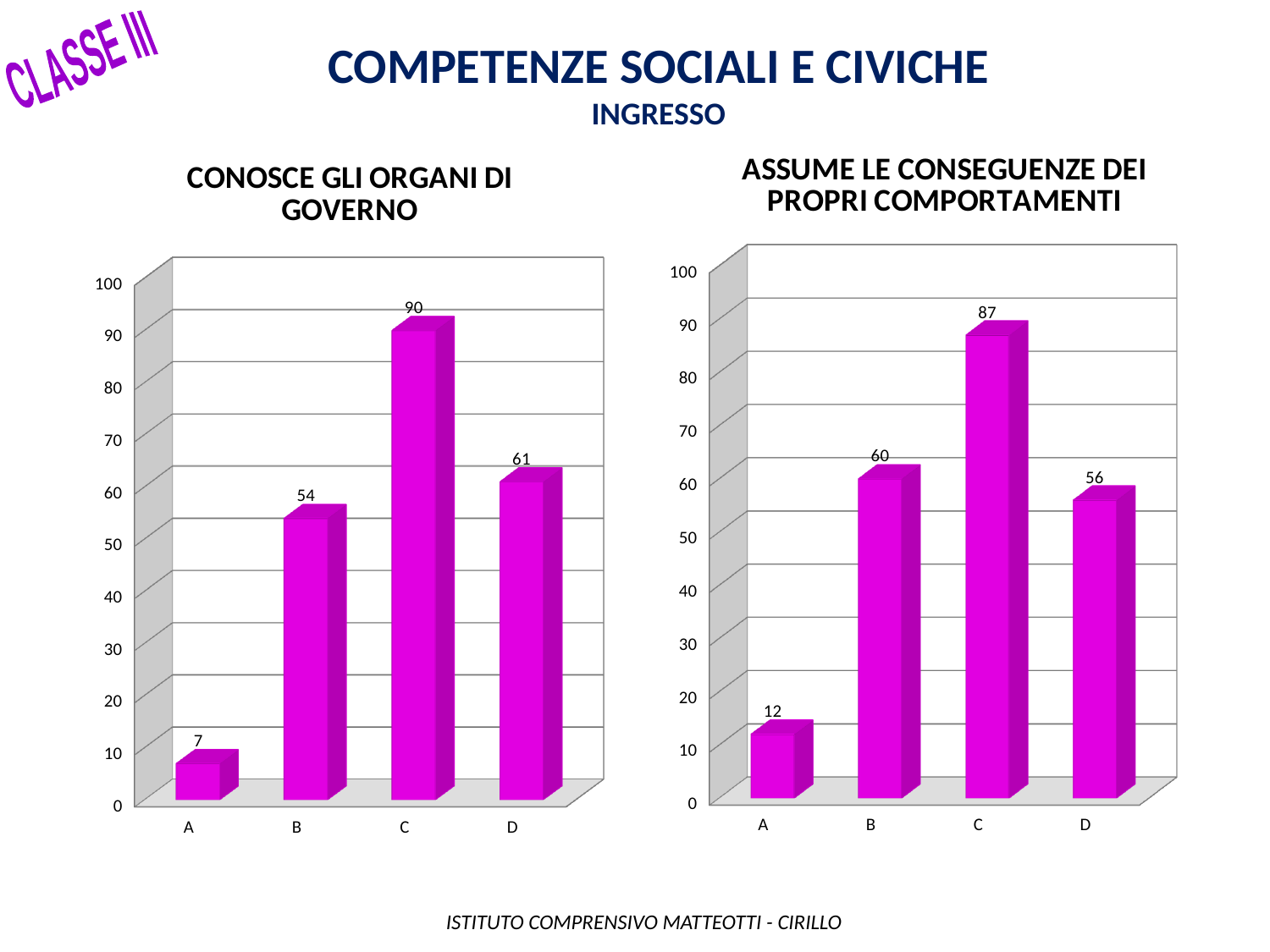
In the 'ASSUME LE CONSEGUENZE DEI PROPRI COMPORTAMENTI' chart, what is the value for category B? 60 In the 'ASSUME LE CONSEGUENZE DEI PROPRI COMPORTAMENTI' chart, which category has the lowest value? A What is the title of the chart on the right side of the slide? ASSUME LE CONSEGUENZE DEI PROPRI COMPORTAMENTI In the 'ASSUME LE CONSEGUENZE DEI PROPRI COMPORTAMENTI' chart, what is the value for category D? 56 In the 'ASSUME LE CONSEGUENZE DEI PROPRI COMPORTAMENTI' chart, what is the difference between the values for B and A? 48 In the 'CONOSCE GLI ORGANI DI GOVERNO' chart, which is larger, the value for B or the value for D? D In the 'CONOSCE GLI ORGANI DI GOVERNO' chart, what is the difference between the values for C and D? 29 In the 'CONOSCE GLI ORGANI DI GOVERNO' chart, what is the value for category C? 90 How many categories are shown in the 'ASSUME LE CONSEGUENZE DEI PROPRI COMPORTAMENTI' chart? 4 In the 'CONOSCE GLI ORGANI DI GOVERNO' chart, which category has the highest value? C What kind of chart is the 'CONOSCE GLI ORGANI DI GOVERNO' chart? Bar chart In the 'CONOSCE GLI ORGANI DI GOVERNO' chart, what is the value for category A? 7